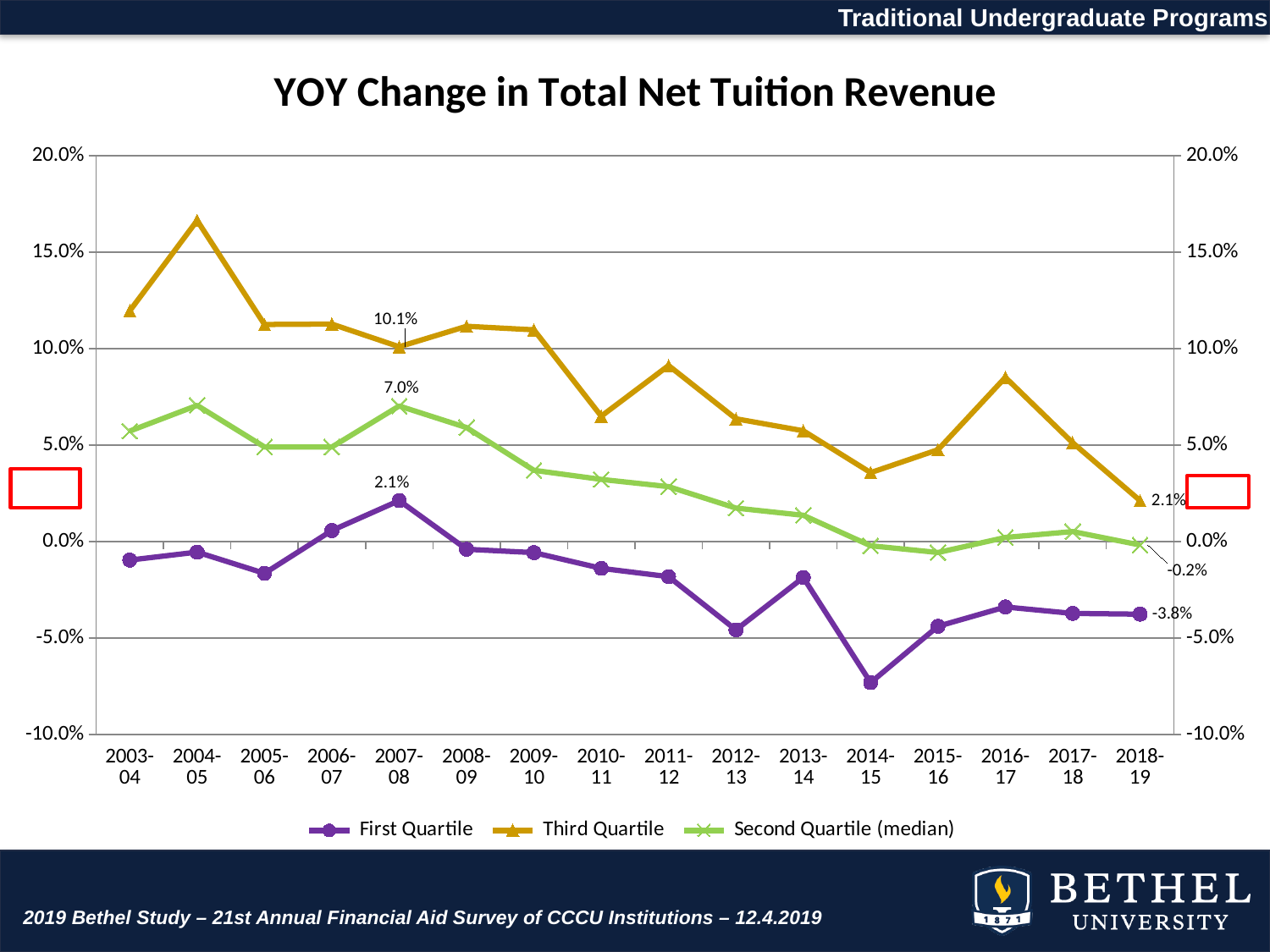
Does the Second Quartile (median) line rise or fall between 2007-08 and 2014-15? fall In which year does the First Quartile line reach its lowest value? 2014-15 What kind of chart is shown on the slide? line chart In 2007-08, how much higher is the Third Quartile value than the First Quartile value? 8.0% Is the Third Quartile value for 2004-05 greater or less than 15.0%? greater In 2018-19, what is the difference between the Third Quartile value and the First Quartile value? 5.9% What is the Second Quartile (median) value for 2018-19? -0.2% What is the First Quartile value for 2018-19? -3.8% How many academic years are plotted along the x axis? 16 How many series does the legend list? 3 In which year does the Third Quartile line reach its highest value? 2004-05 What is the Third Quartile value for 2007-08? 10.1%